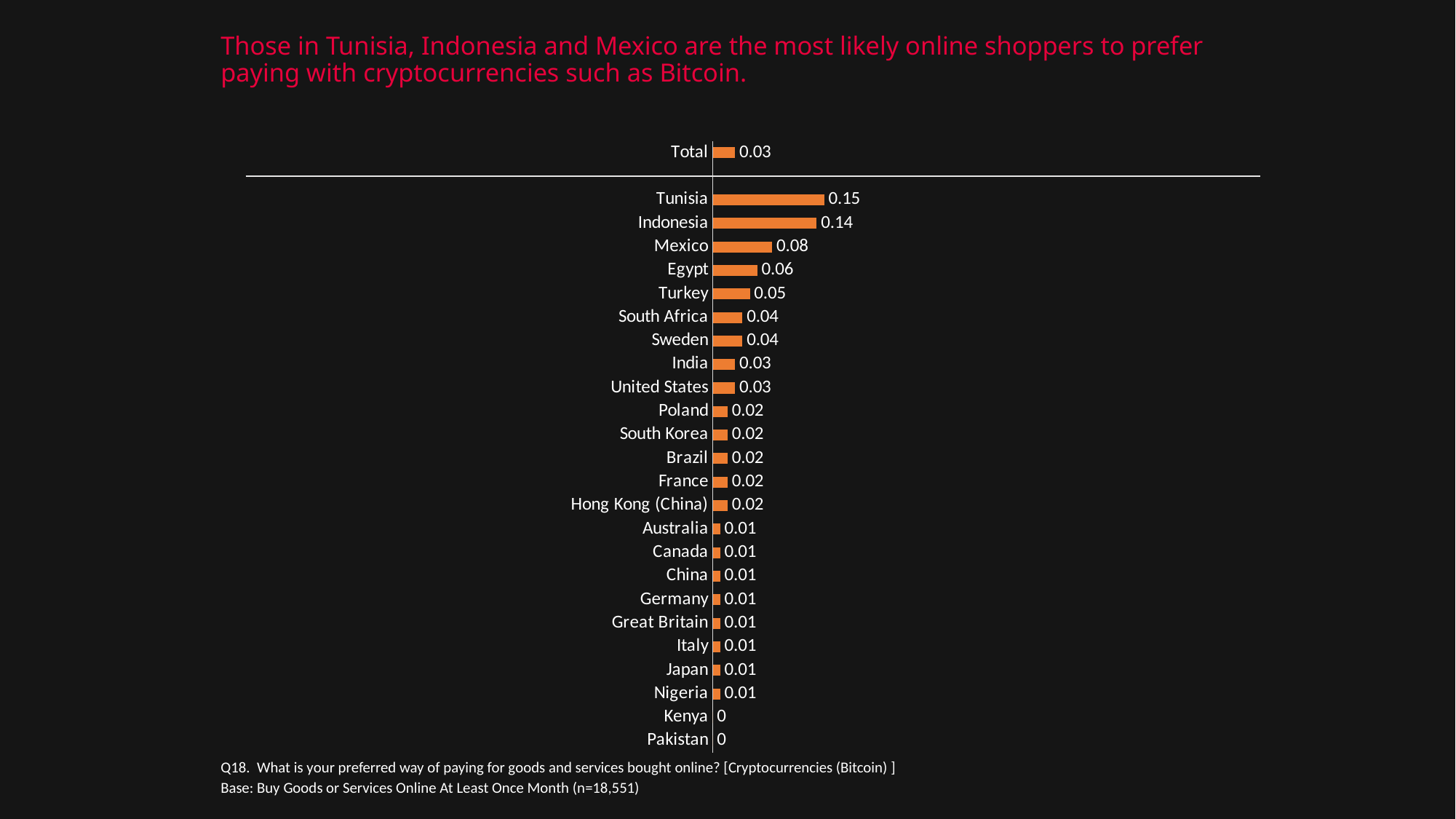
Which country has the highest value? Tunisia How many countries are listed below the Total bar? 24 What is the value for Mexico? 0.08 What is the value for Total? 0.03 What is the value for Kenya? 0 What kind of chart is shown on the slide? Bar chart What is the difference between the values for Tunisia and Indonesia? 0.01 What is the value for Sweden? 0.04 What is the difference between the values for Mexico and Egypt? 0.02 Which is larger, the value for Egypt or the value for Poland? Egypt What is the value for Tunisia? 0.15 Which is larger, the value for Turkey or the value for India? Turkey